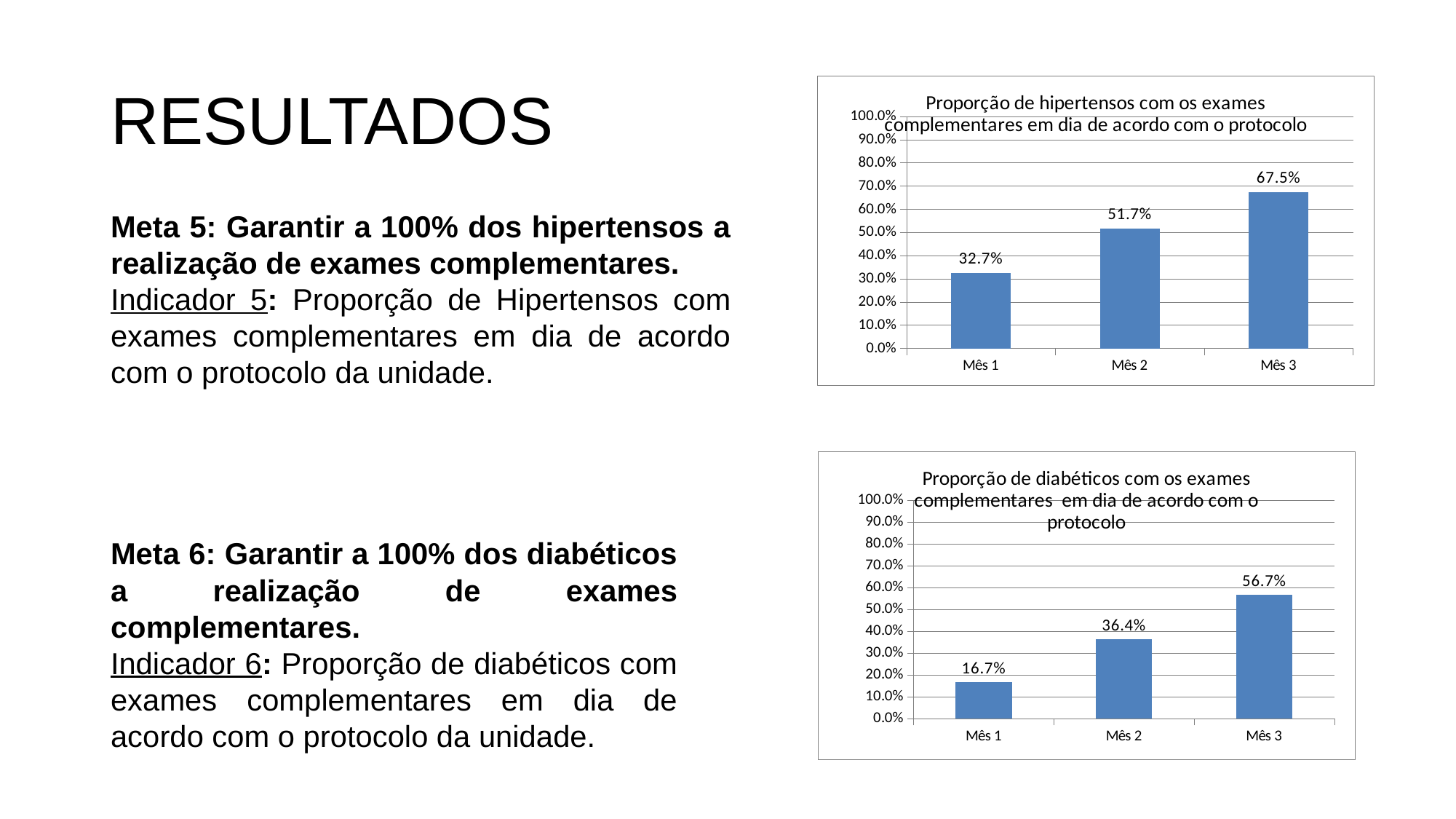
What is the title of the top chart? Proporção de hipertensos com os exames complementares em dia de acordo com o protocolo In the top chart (hipertensos), which month has the highest value? Mês 3 What type of chart is the bottom chart (diabéticos)? Bar chart In the bottom chart (diabéticos), what is the difference between the values for Mês 2 and Mês 1? 19.7% In the bottom chart (diabéticos), what is the value for Mês 3? 56.7% In the top chart (hipertensos), what is the difference between the values for Mês 3 and Mês 1? 34.8% In the top chart (Proporção de hipertensos com os exames complementares em dia de acordo com o protocolo), what is the value for Mês 2? 51.7% In the bottom chart (Proporção de diabéticos com os exames complementares em dia de acordo com o protocolo), what is the value for Mês 1? 16.7% Which is larger: the Mês 3 value in the top chart (hipertensos) or the Mês 3 value in the bottom chart (diabéticos)? Top chart (hipertensos), 67.5% In the top chart (hipertensos), how many months are plotted? 3 In the bottom chart (diabéticos), which month has the lowest value? Mês 1 In the top chart (hipertensos), do the values rise or fall from Mês 1 to Mês 3? rise